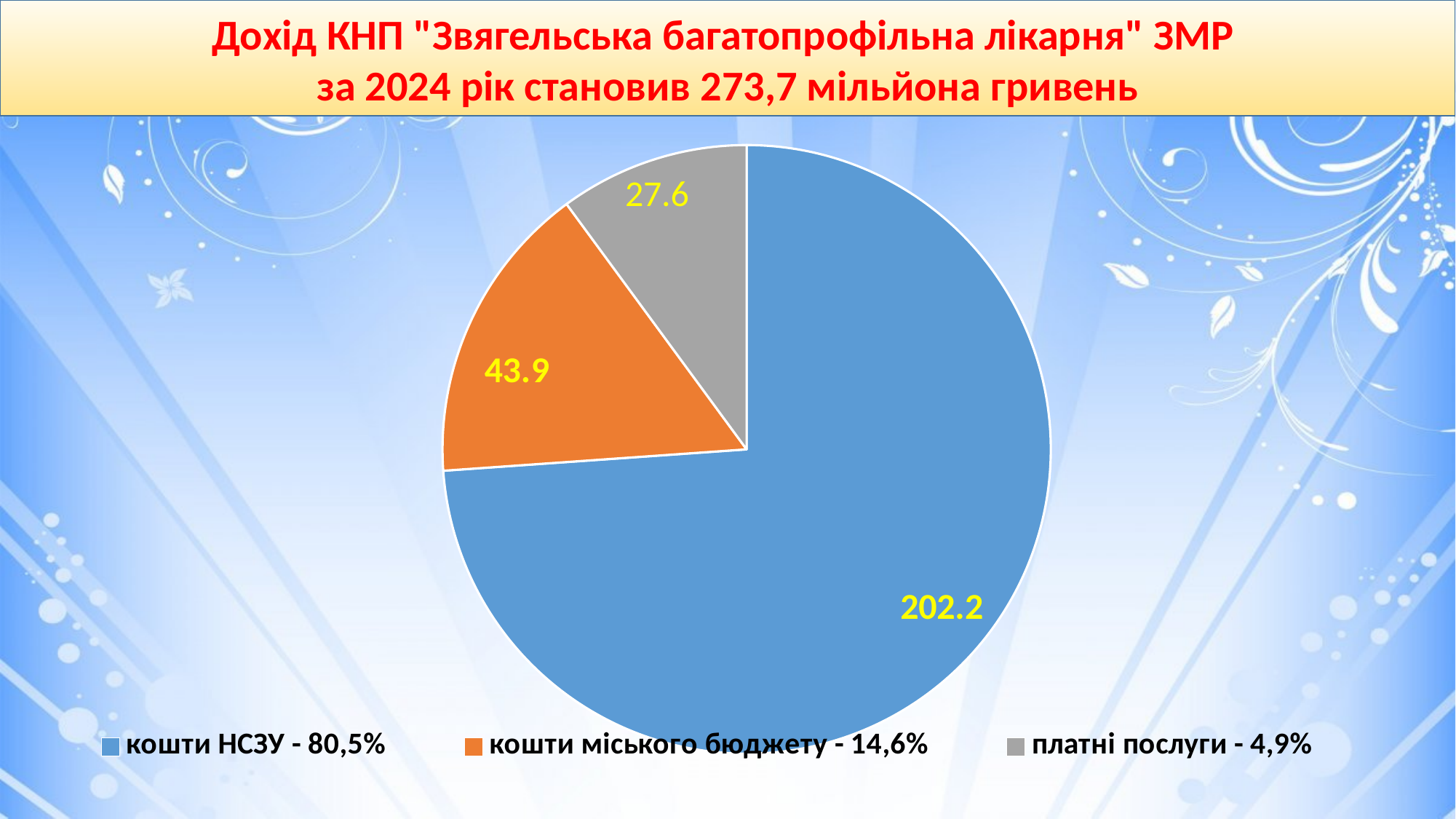
How many slices does the pie chart have? 3 Which is larger: the value for "кошти міського бюджету" or the value for "платні послуги"? кошти міського бюджету What is the difference between the values for "кошти НСЗУ" and "кошти міського бюджету"? 158.3 What type of chart is shown on the slide? pie chart Which slice of the pie chart is the largest? кошти НСЗУ What is the difference between the values for "кошти міського бюджету" and "платні послуги"? 16.3 Which slice of the pie chart is the smallest? платні послуги What colour is the slice for "платні послуги"? grey What is the value shown for the slice "кошти НСЗУ"? 202.2 What share of the pie does "кошти НСЗУ" represent, according to the legend? 80,5% What is the value shown for the slice "платні послуги"? 27.6 What is the value shown for the slice "кошти міського бюджету"? 43.9